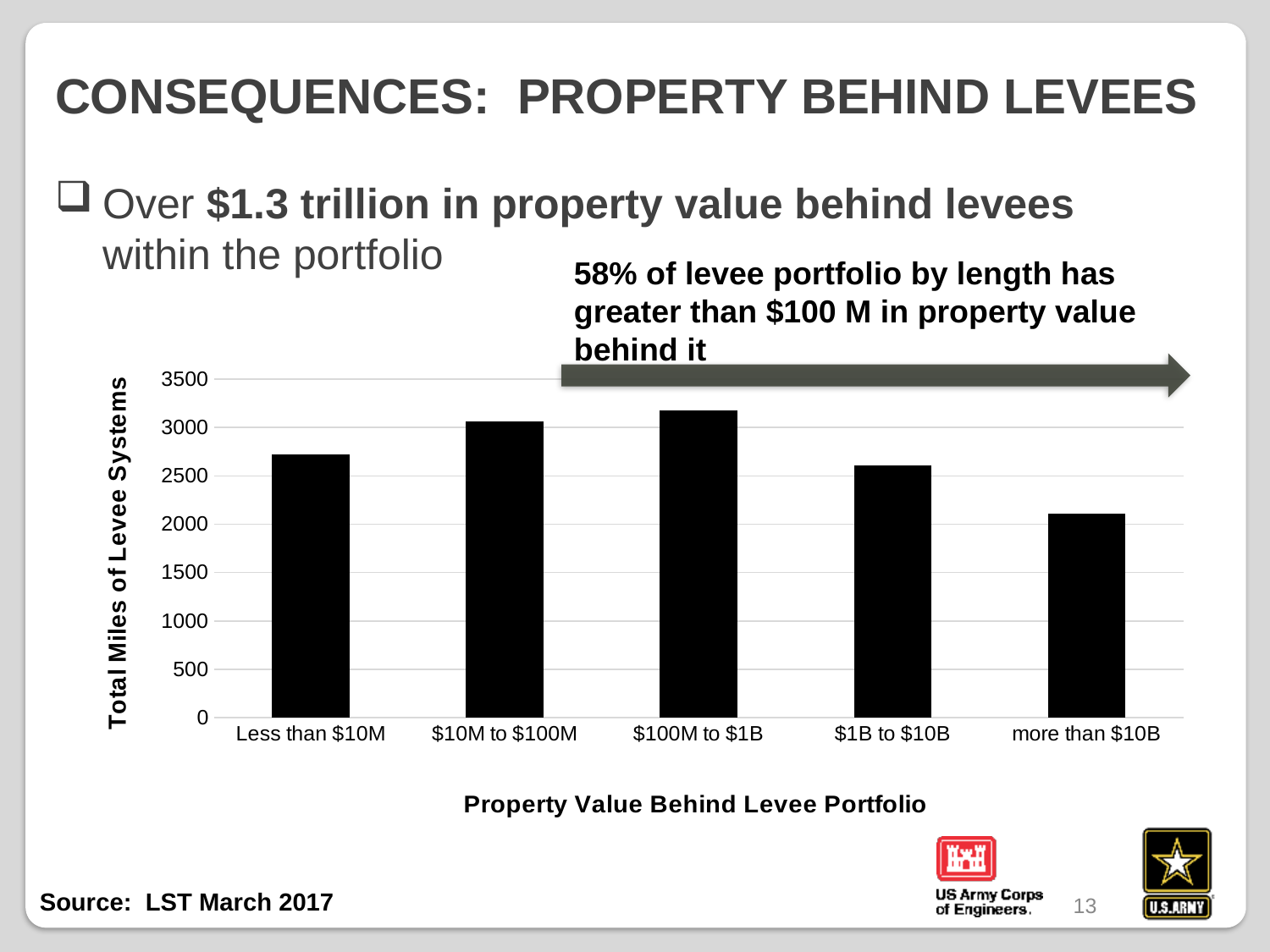
Is the value for $1B to $10B greater or less than 3000? less Which has more total miles of levee systems: $10M to $100M or $1B to $10B? $10M to $100M Which property value category has the lowest total miles of levee systems? more than $10B Do the values rise or fall from $100M to $1B through more than $10B? fall Is the value for more than $10B greater or less than 2500? less Is the value for $100M to $1B greater or less than 3000? greater Which has more total miles of levee systems: Less than $10M or more than $10B? Less than $10M Which property value category has the highest total miles of levee systems? $100M to $1B How many property value categories are shown on the x axis of the chart? 5 What is the title of the chart's vertical axis? Total Miles of Levee Systems What kind of chart is shown on the slide? bar chart